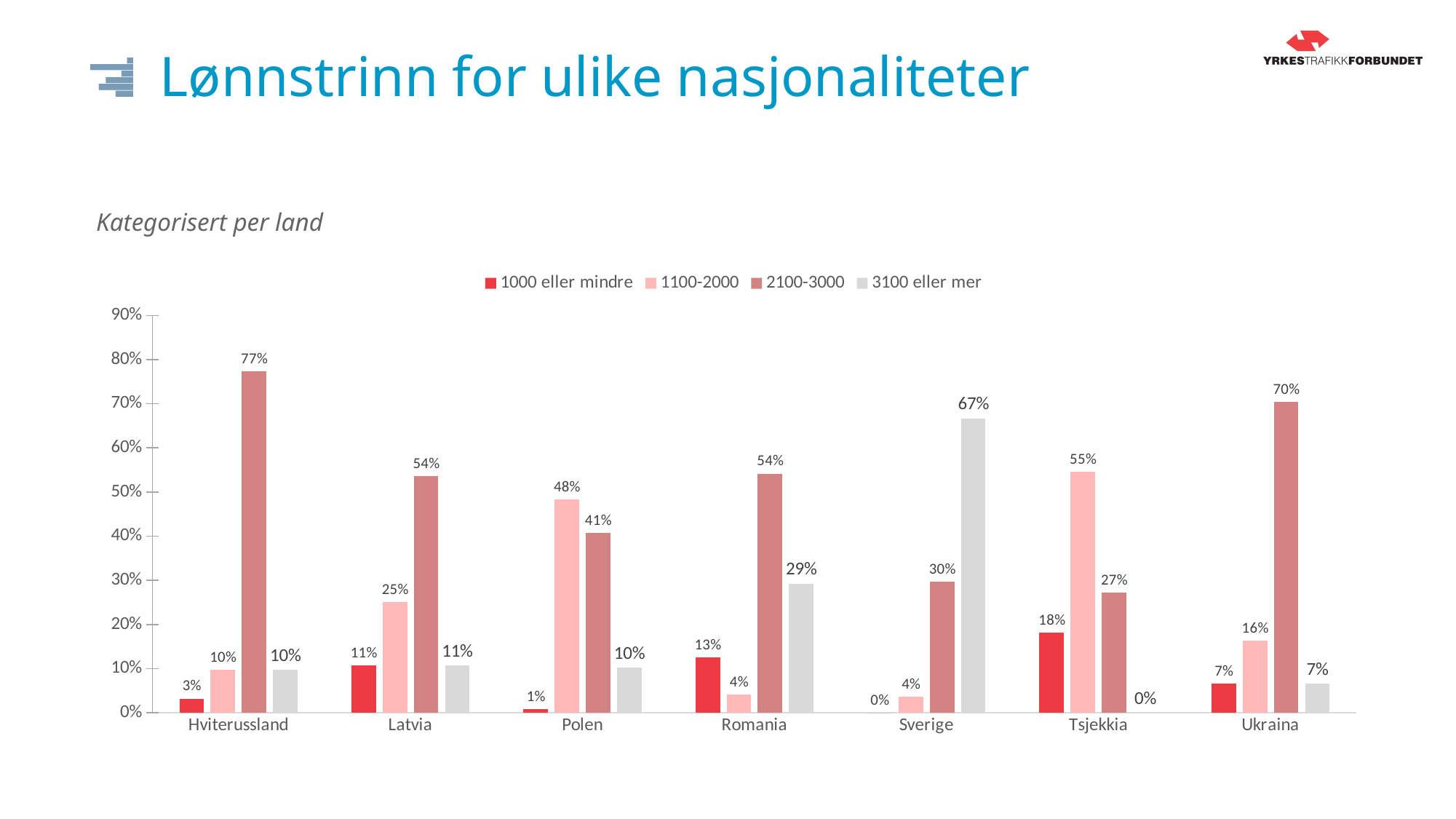
What is the value for Sverige in the 3100 eller mer series? 67% What is the value for Tsjekkia in the 1100-2000 series? 55% What is the value for Polen in the 1000 eller mindre series? 1% Which country has the lowest value in the 1100-2000 series? Romania and Sverige (4%) What is the value for Hviterussland in the 2100-3000 series? 77% Which is larger: the 1100-2000 value for Polen or the 2100-3000 value for Polen? 1100-2000 (48%) What is the subtitle shown above the chart? Kategorisert per land How many countries are shown on the x axis? 7 Which country has the highest value in the 2100-3000 series? Hviterussland What is the difference between the 2100-3000 values for Ukraina and Tsjekkia? 43 percentage points How many series does the legend list? 4 What kind of chart is shown on the slide? Bar chart